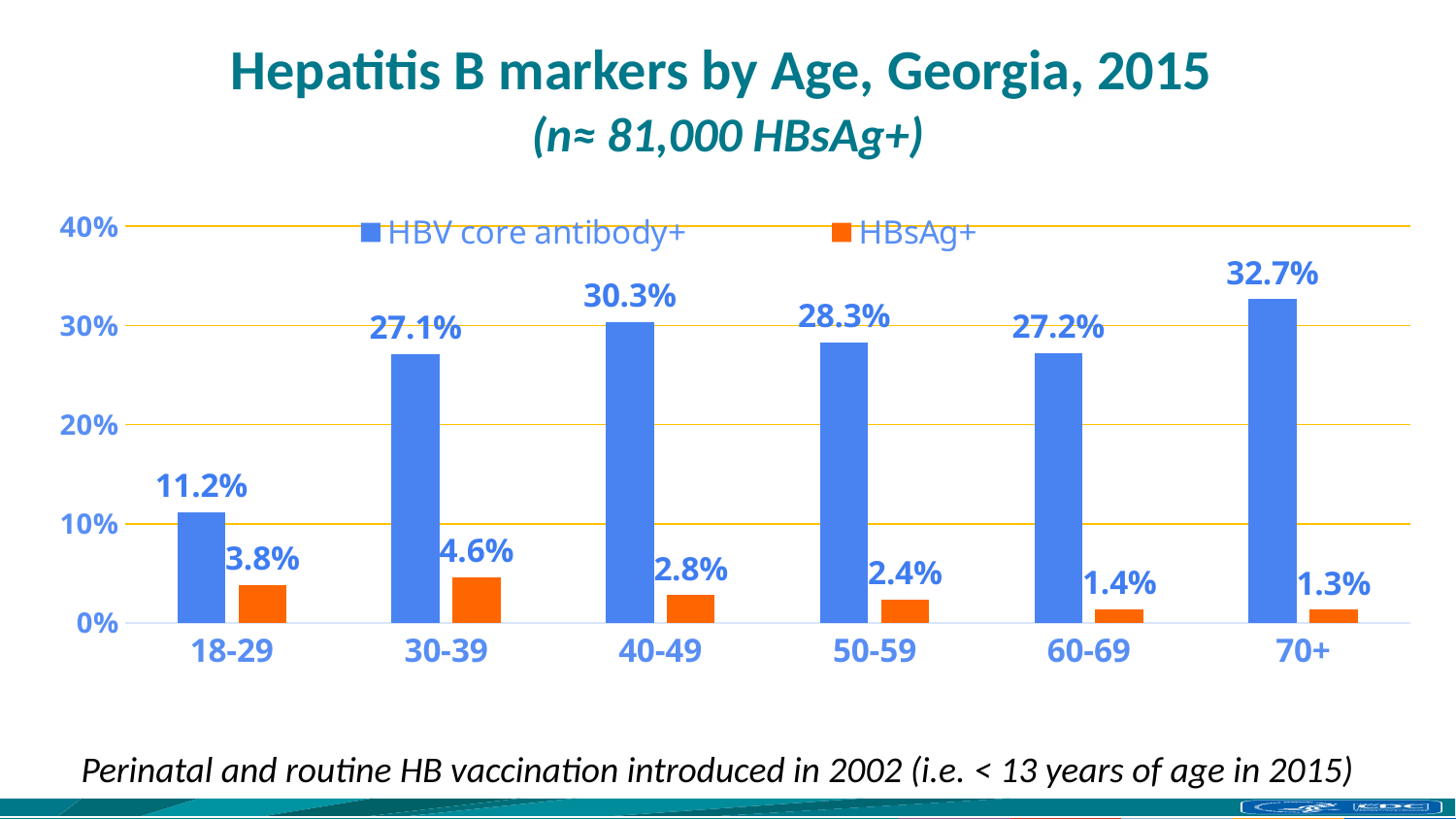
Which age group has the lowest HBV core antibody+ value? 18-29 Is the HBV core antibody+ value for the 50-59 age group greater or less than 20%? greater Which age group has the highest HBV core antibody+ value? 70+ What is the difference between the HBV core antibody+ values for the 70+ and 18-29 age groups? 21.5% Which is larger, the HBsAg+ value for 18-29 or for 40-49? 18-29 What kind of chart is shown on the slide? Bar chart What is the HBsAg+ value for the 30-39 age group? 4.6% What is the HBsAg+ value for the 70+ age group? 1.3% What is the HBV core antibody+ value for the 40-49 age group? 30.3% How many age groups are shown on the x axis? 6 Which age group has the highest HBsAg+ value? 30-39 How many series does the legend list? 2